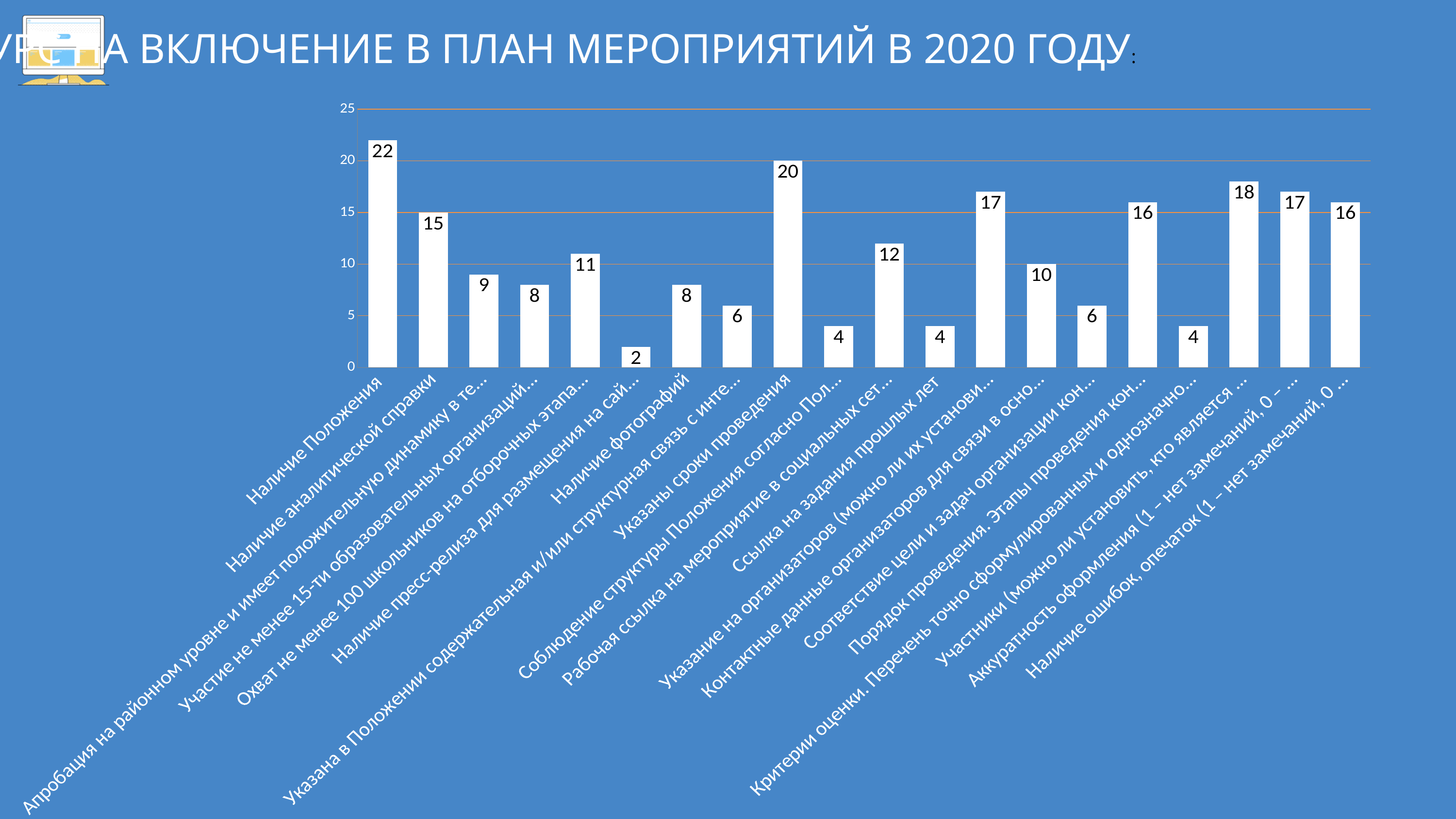
How many bars are shown on the chart? 20 What kind of chart is shown on the slide? bar chart What is the value for "Наличие фотографий"? 8 What is the value for "Наличие аналитической справки"? 15 What is the difference between the values for "Наличие Положения" and "Указаны сроки проведения"? 2 What is the lowest value shown on the chart? 2 What is the value for "Наличие Положения"? 22 What is the highest value marked on the vertical axis? 25 Which category has the highest value? Наличие Положения What is the value for "Указаны сроки проведения"? 20 What is the value for "Ссылка на задания прошлых лет"? 4 Which is larger, the value for "Наличие аналитической справки" or for "Наличие фотографий"? Наличие аналитической справки